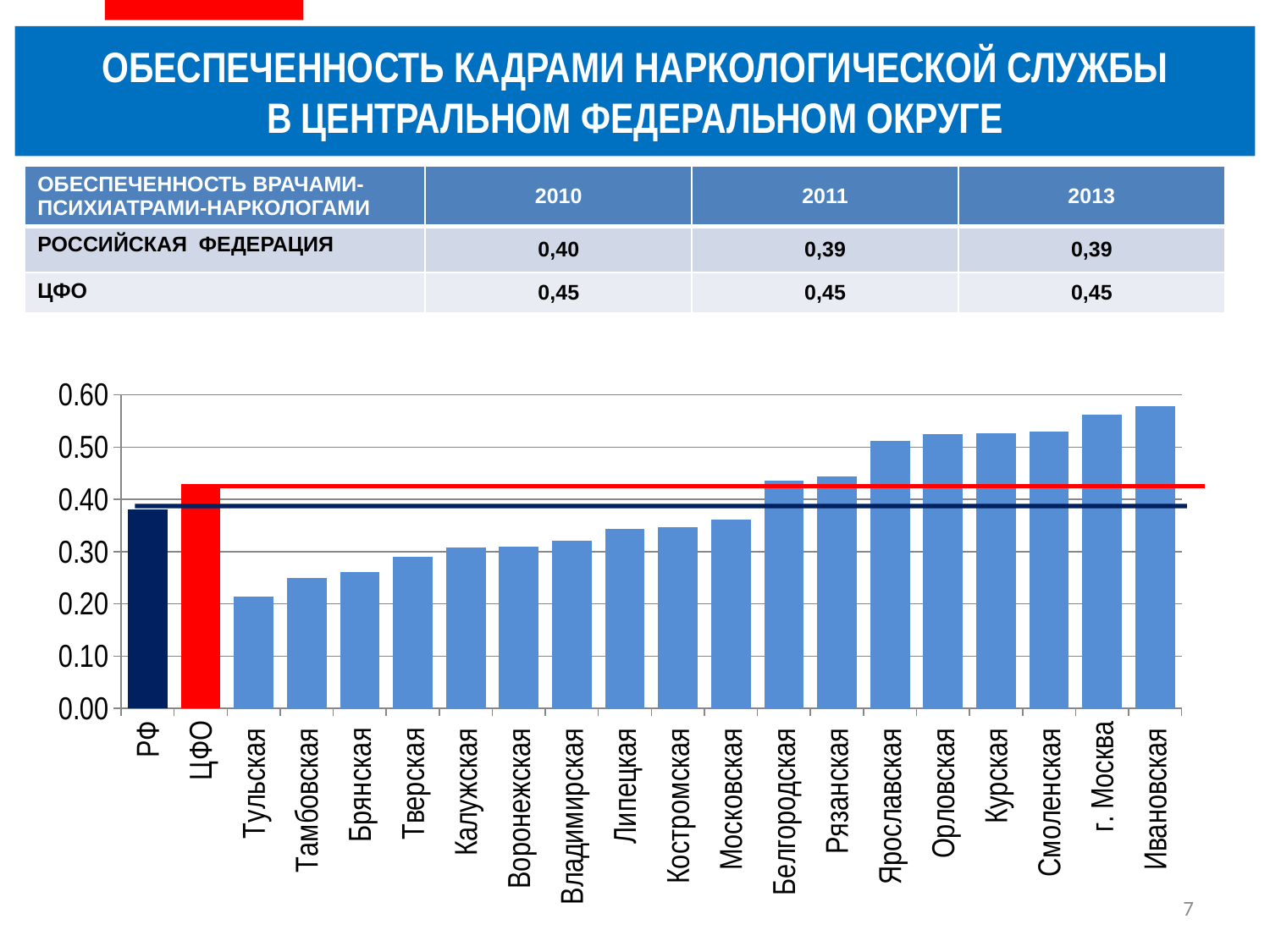
Is the value for Тамбовская greater or less than 0.30? less Which is larger, the value for г. Москва or the value for Московская? г. Москва How many categories (bars) are shown on the chart? 20 What colour is the bar for ЦФО? red Is the value for г. Москва greater or less than 0.50? greater Is the value for Тульская greater or less than 0.30? less Which region has the lowest bar on the chart? Тульская Do the bars for the regions from Тульская to Ивановская rise or fall along the x axis? rise What kind of chart is shown on the slide? bar chart Which region has the highest bar on the chart? Ивановская